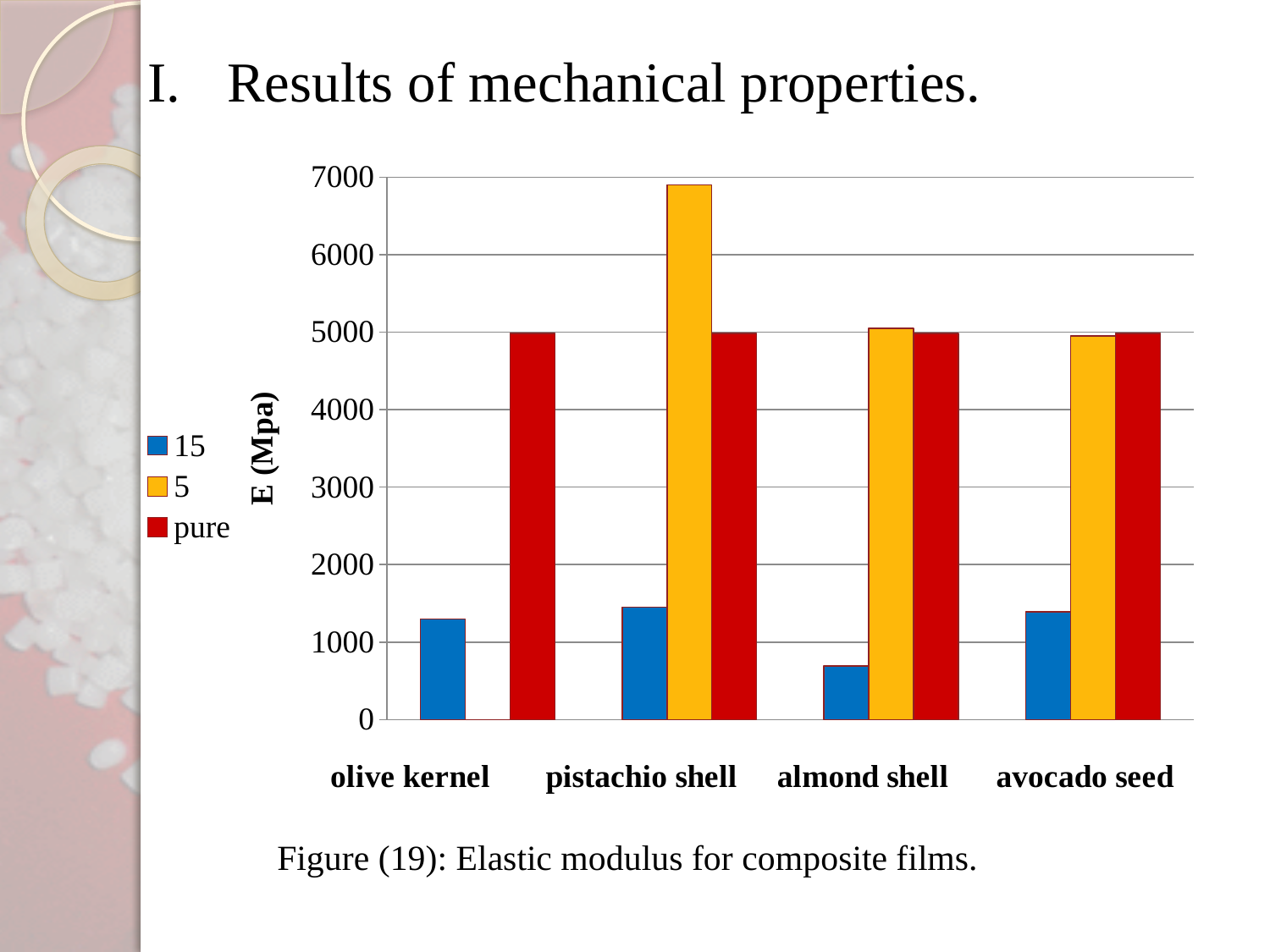
For pistachio shell, which is larger: the '5' series or the 'pure' series? 5 Is the value for the '15' series at almond shell greater or less than 1000? less Is the value for the '5' series at pistachio shell greater or less than 6000? greater What is the label of the y axis? E (Mpa) Which category has the highest value for the '5' series? pistachio shell What kind of chart is shown on the slide? bar chart How many categories are shown on the x axis? 4 Which category has the lowest value for the '15' series? almond shell Is the value for the '15' series at olive kernel greater or less than 1000? greater What are the entries listed in the legend? 15, 5, pure How many series does the legend list? 3